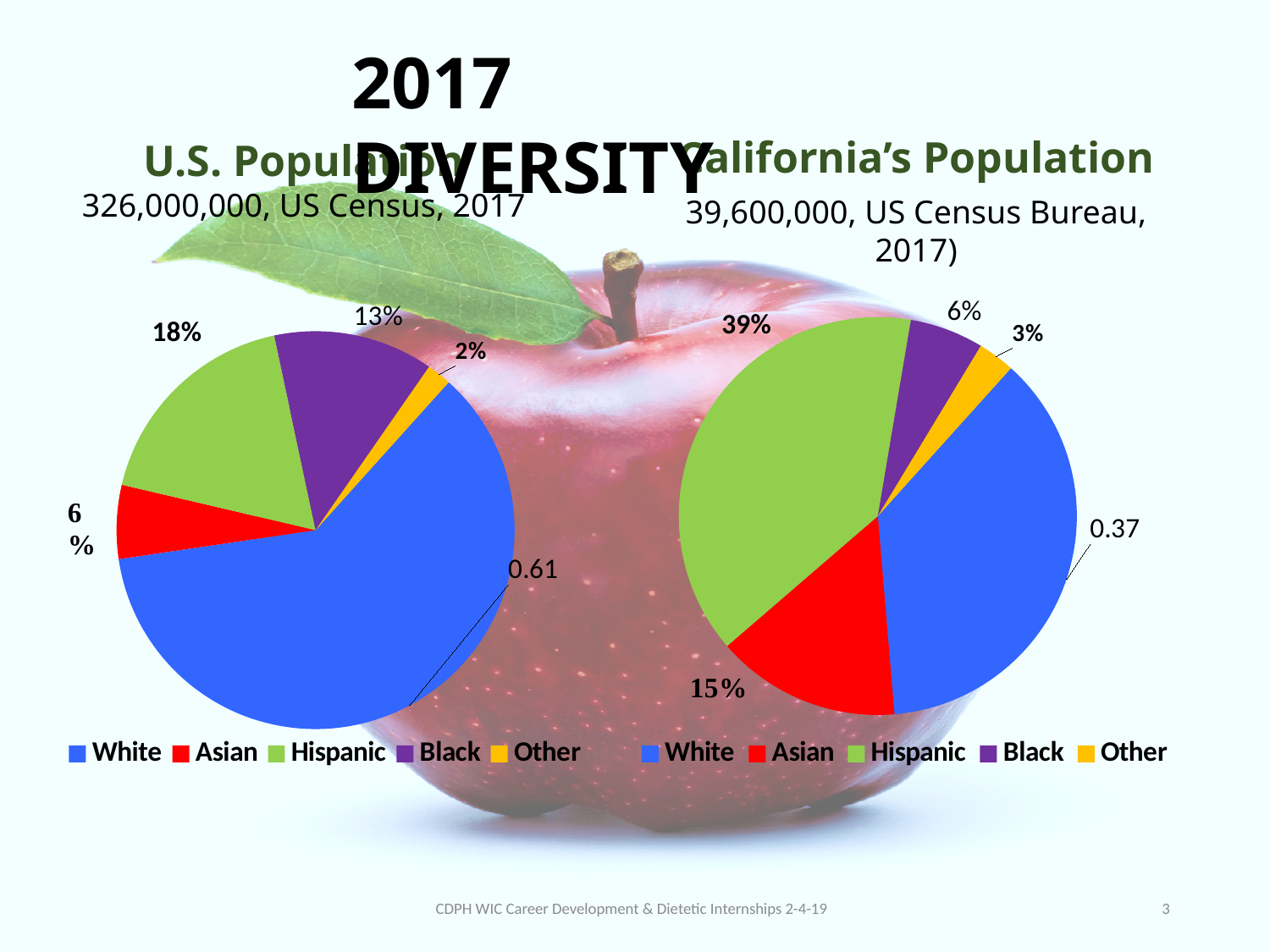
On the left pie chart (U.S. Population), which category has the smallest slice? Other How many categories does the legend of the left pie chart list? 5 What kind of chart is used on the right side of the slide for California's Population? Pie chart On the right pie chart (California's Population), what value is shown for the Hispanic slice? 39% On the right pie chart (California's Population), what is the difference between the Hispanic and Asian percentages? 24% On the left pie chart (U.S. Population), what is the difference between the Hispanic and Black percentages? 5% On the right pie chart (California's Population), what value is shown for the White slice? 0.37 On the right pie chart (California's Population), which category has the largest slice? Hispanic On the right pie chart (California's Population), what value is shown for the Asian slice? 15% On the left pie chart (U.S. Population), what value is shown for the White slice? 0.61 On the left pie chart (U.S. Population), what value is shown for the Hispanic slice? 18% On the right pie chart (California's Population), which is larger, the Black slice or the Other slice? Black